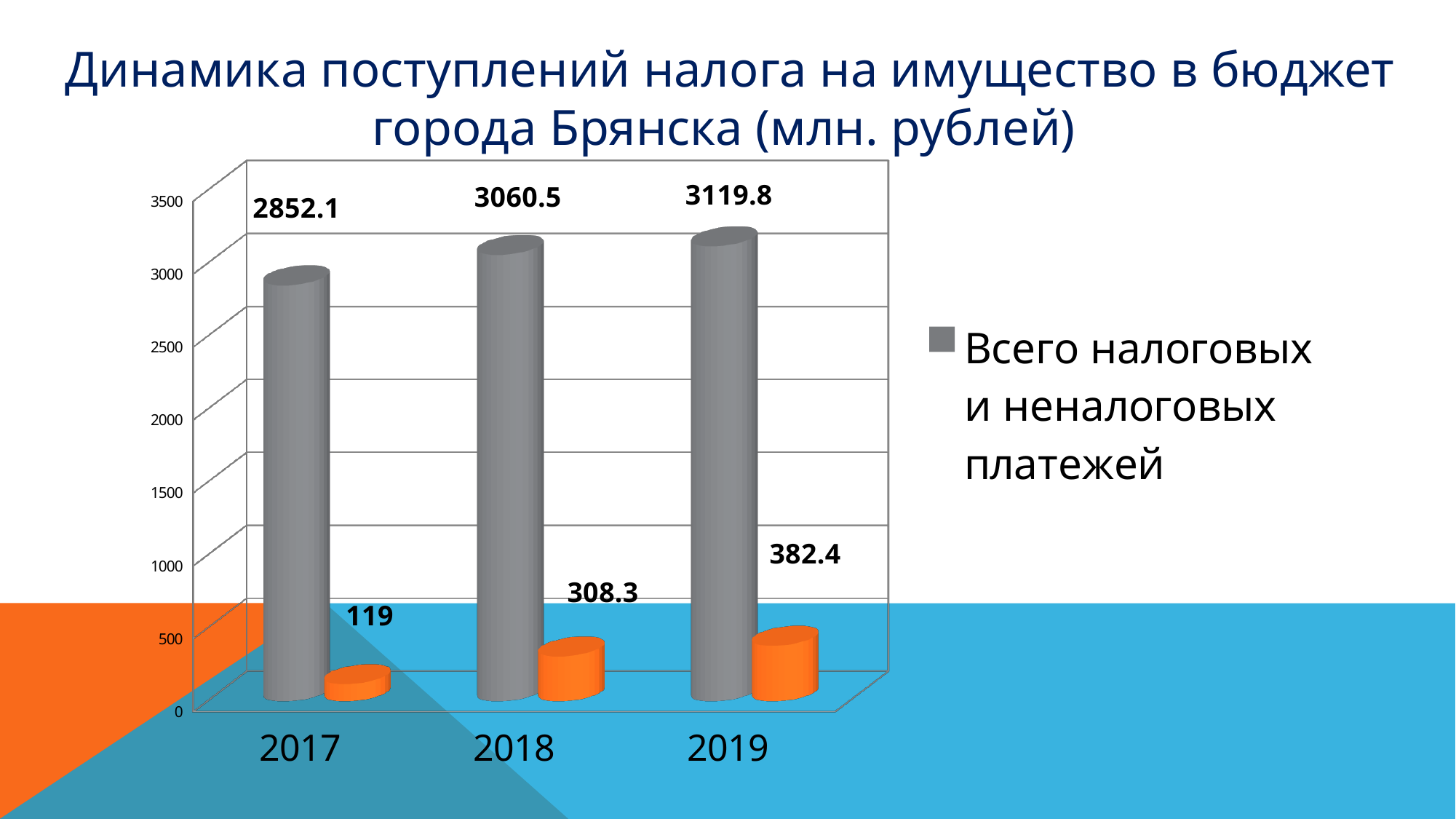
Do the values for 'Всего налоговых и неналоговых платежей' rise or fall from 2017 to 2019? Rise In which year is the orange series lowest? 2017 What is the value of the orange series in 2018? 308.3 What is the value for 'Всего налоговых и неналоговых платежей' in 2019? 3119.8 What is the difference between 'Всего налоговых и неналоговых платежей' in 2018 and 2017? 208.4 What is the difference between the orange series values in 2019 and 2018? 74.1 How many years are shown on the x axis? 3 What kind of chart is shown on the slide? Bar chart In which year is 'Всего налоговых и неналоговых платежей' highest? 2019 What is the value for 'Всего налоговых и неналоговых платежей' in 2017? 2852.1 Which is larger: the orange series value in 2019 or in 2017? 2019 What is the value of the orange series in 2017? 119